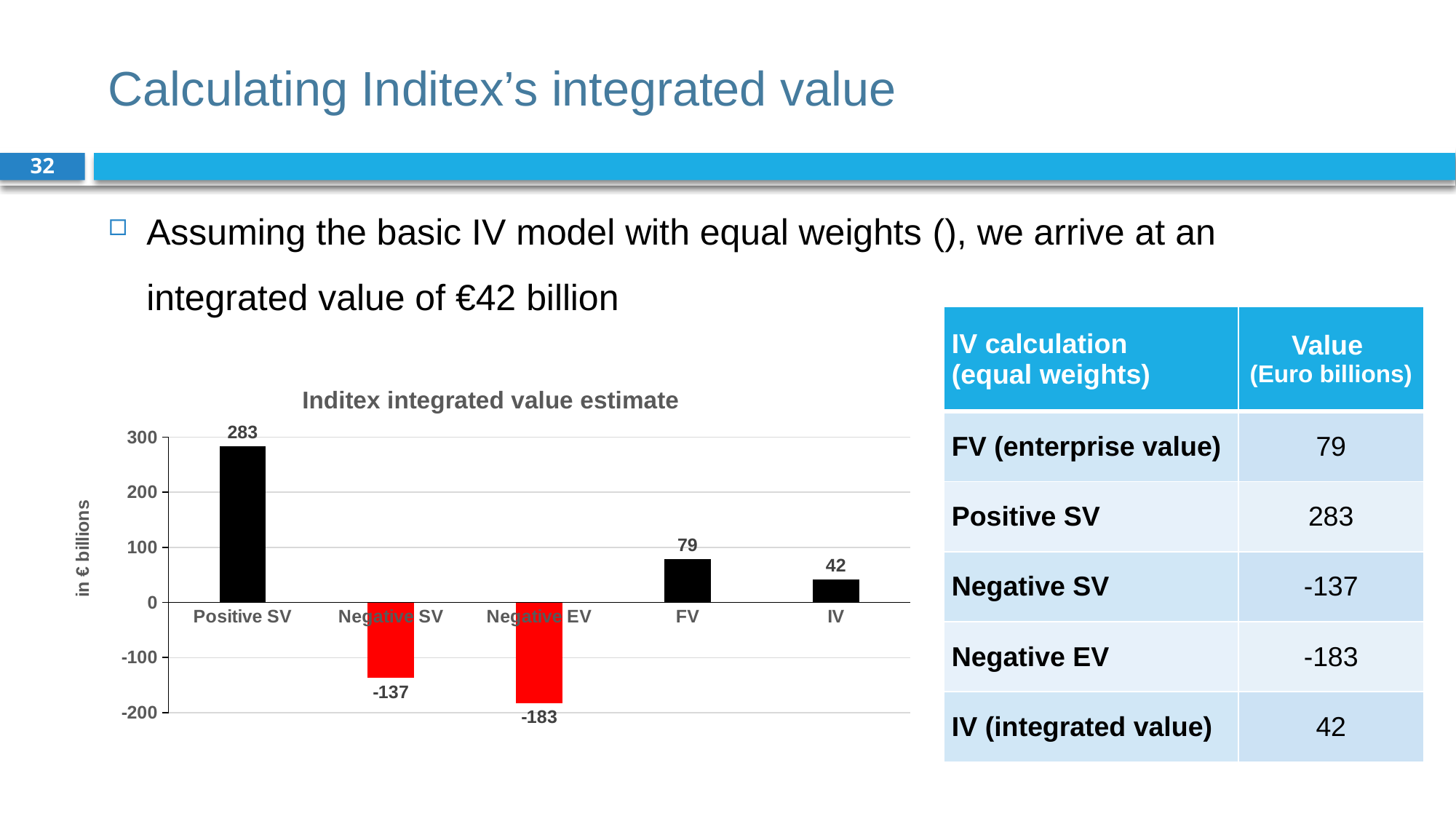
What is the value for FV in the chart? 79 What is the value for Negative EV in the chart? -183 What is the difference between the values for Positive SV and FV? 204 What is the difference between the values for FV and IV? 37 What is the value for IV in the chart? 42 How many categories are shown on the x axis of the chart? 5 What is the value for Positive SV in the chart? 283 What is the title of the chart? Inditex integrated value estimate Which category has the highest value in the chart? Positive SV Which is larger, the value for Negative SV or the value for Negative EV? Negative SV Which category has the lowest value in the chart? Negative EV What kind of chart is shown on the slide? Bar chart